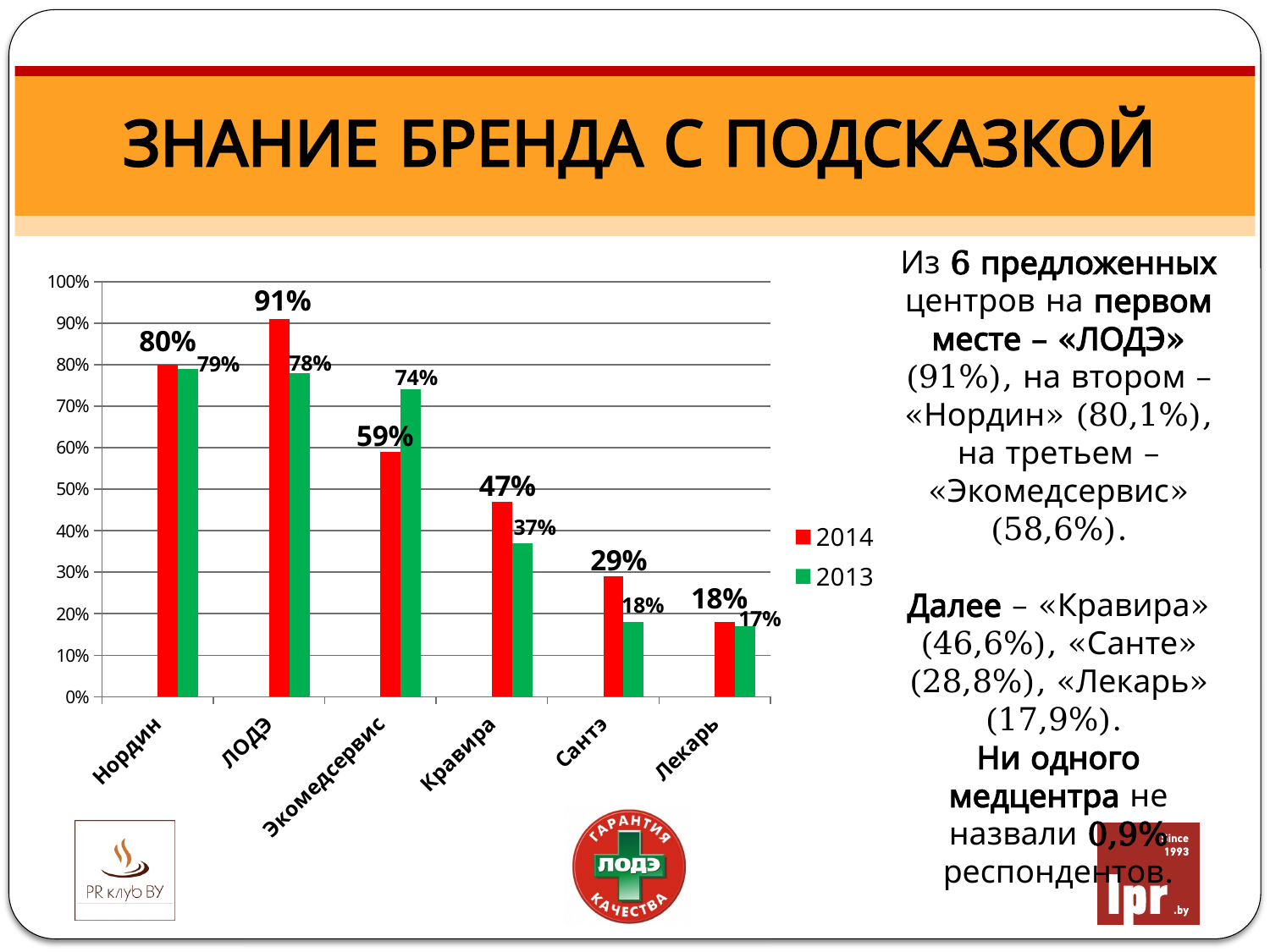
What kind of chart is shown on the slide? Bar chart Which colour represents the 2013 series in the legend? Green Which is larger for ЛОДЭ: the 2014 value or the 2013 value? 2014 Which category has the lowest 2013 value? Лекарь Which category has the highest 2014 value? ЛОДЭ What is the 2013 value for Экомедсервис? 74% How many series does the legend list? 2 What is the difference between the 2014 and 2013 values for Экомедсервис? 15% What is the 2014 value for Кравира? 47% What is the 2013 value for Сантэ? 18% What is the 2014 value for ЛОДЭ? 91% How many categories are shown on the x axis? 6